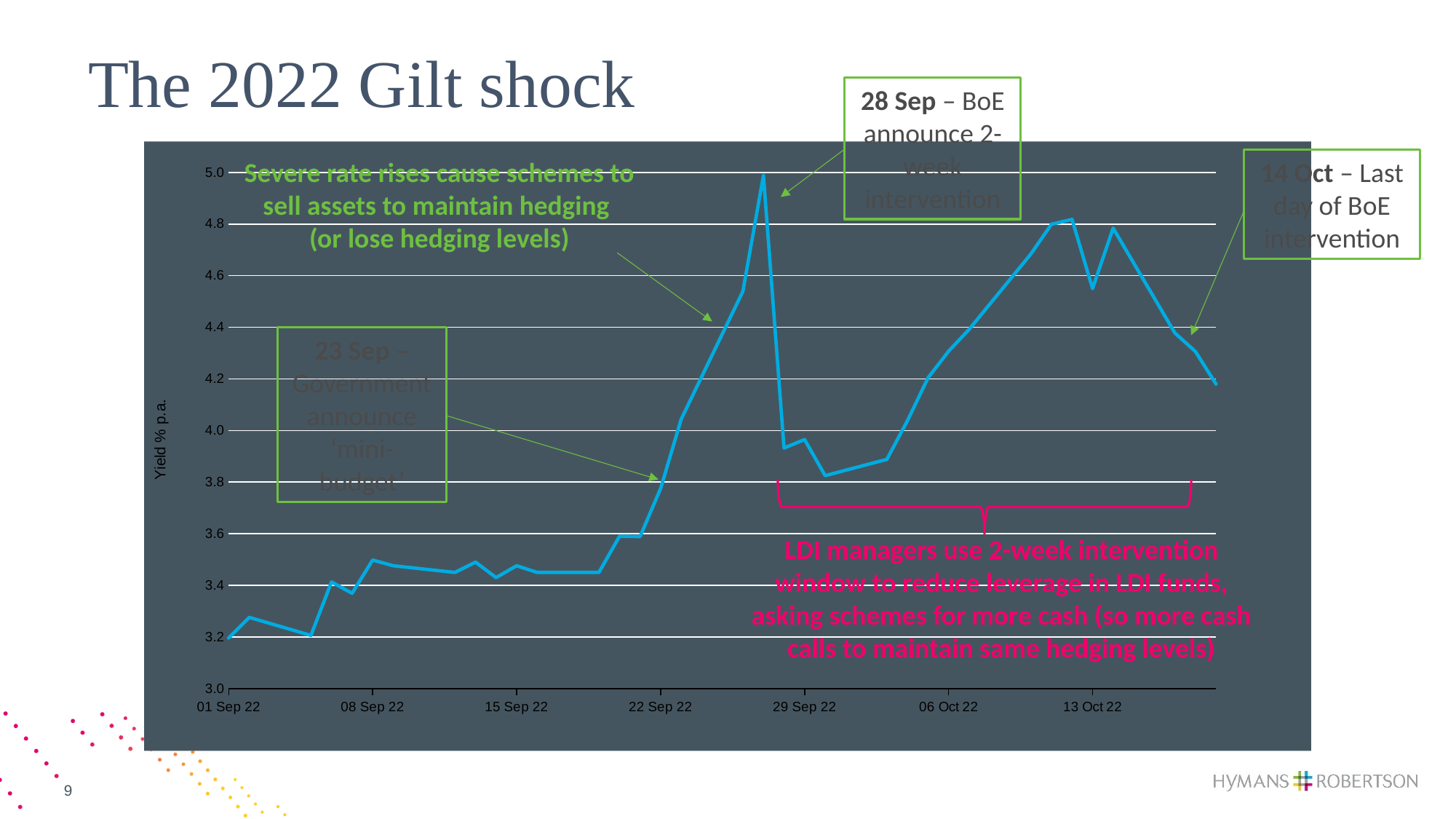
Is the value for 29 Sep 22 greater or less than 4.2? less Is the value for 22 Sep 22 greater or less than 4.0? less Does the yield rise or fall between 01 Sep 22 and 22 Sep 22? rise What type of chart is shown on the slide? line chart Which is higher, the value for 13 Oct 22 or the value for 22 Sep 22? 13 Oct 22 What is the title of the slide containing the chart? The 2022 Gilt shock Is the peak value of the line greater or less than 4.8? greater What is the label on the y axis of the chart? Yield % p.a. Does the peak of the line occur before or after 29 Sep 22? before